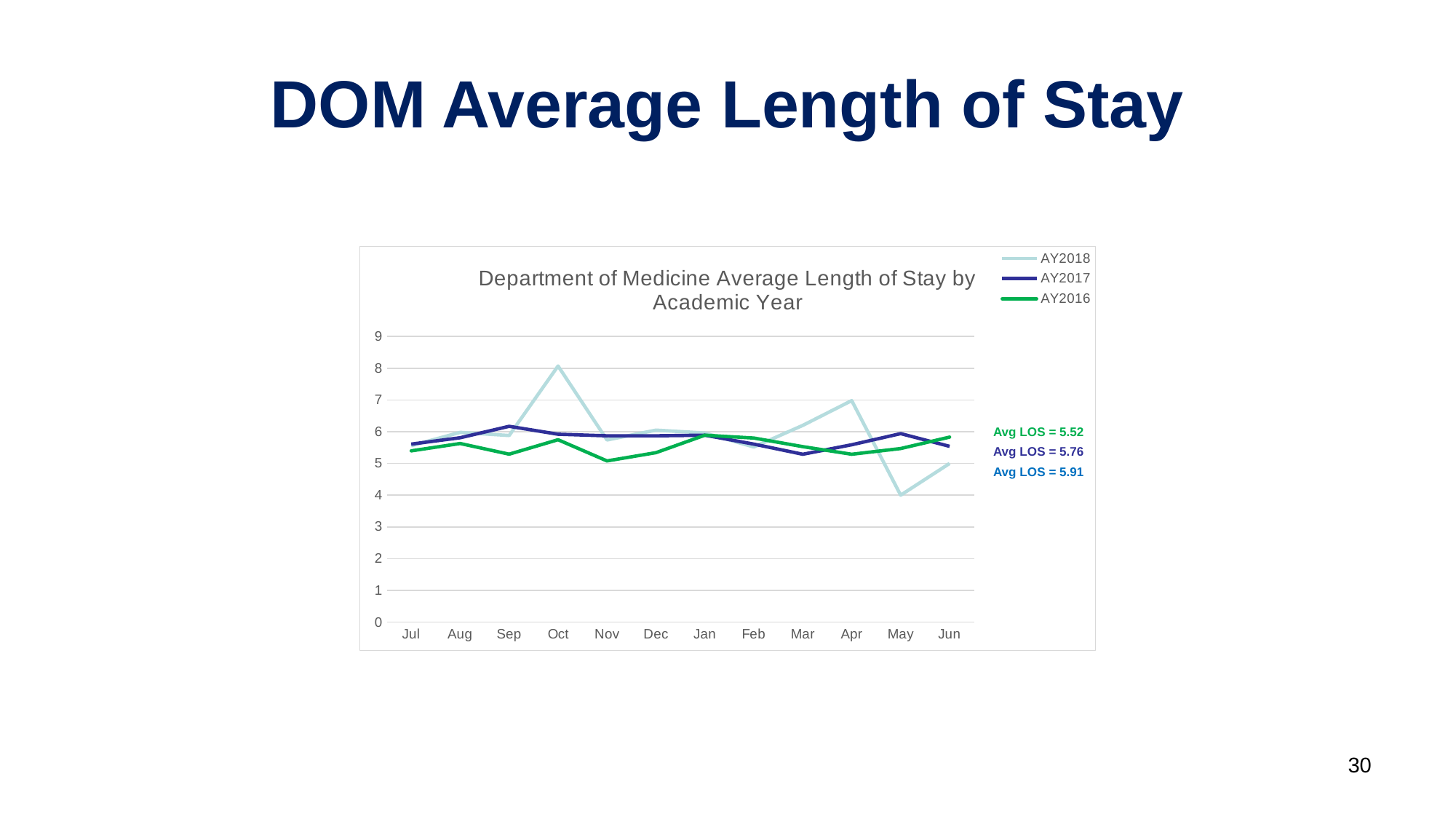
What Avg LOS value is printed in green (AY2016) to the right of the chart? 5.52 Is the AY2018 value for May greater or less than 5? less Which series has the larger value in Apr, AY2018 or AY2017? AY2018 What kind of chart is shown on the slide? line chart How many months are plotted along the x axis? 12 What is the title of the chart? Department of Medicine Average Length of Stay by Academic Year In which month does the AY2018 line reach its highest value? Oct In which month does the AY2018 line reach its lowest value? May Is the AY2018 value for Oct greater or less than 7? greater How many series does the legend list? 3 Is the AY2016 value for Nov greater or less than 6? less Which series has the larger value in Oct, AY2018 or AY2016? AY2018